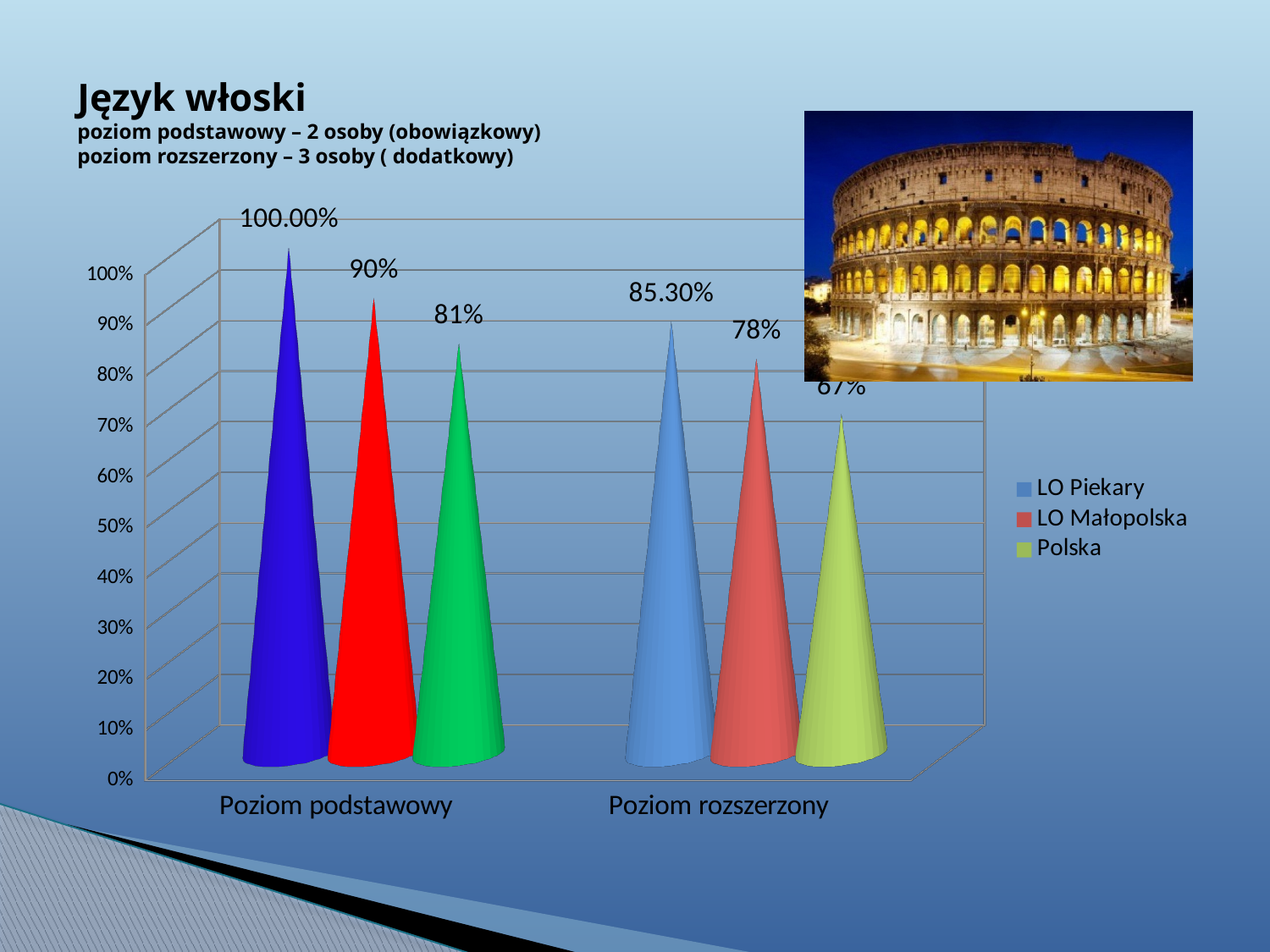
What kind of chart is shown on the slide? bar chart How many series does the legend list? 3 Which series has the lowest value at Poziom rozszerzony? Polska What is the difference between LO Małopolska and Polska at Poziom podstawowy? 9% Which series has the highest value at Poziom podstawowy? LO Piekary Is the value for Polska at Poziom rozszerzony greater or less than 70%? less What is the value for LO Piekary at Poziom podstawowy? 100.00% What is the value for Polska at Poziom podstawowy? 81% Is the value for LO Piekary larger at Poziom podstawowy or at Poziom rozszerzony? Poziom podstawowy What is the value for LO Małopolska at Poziom rozszerzony? 78% What is the value for LO Piekary at Poziom rozszerzony? 85.30% What is the value for LO Małopolska at Poziom podstawowy? 90%